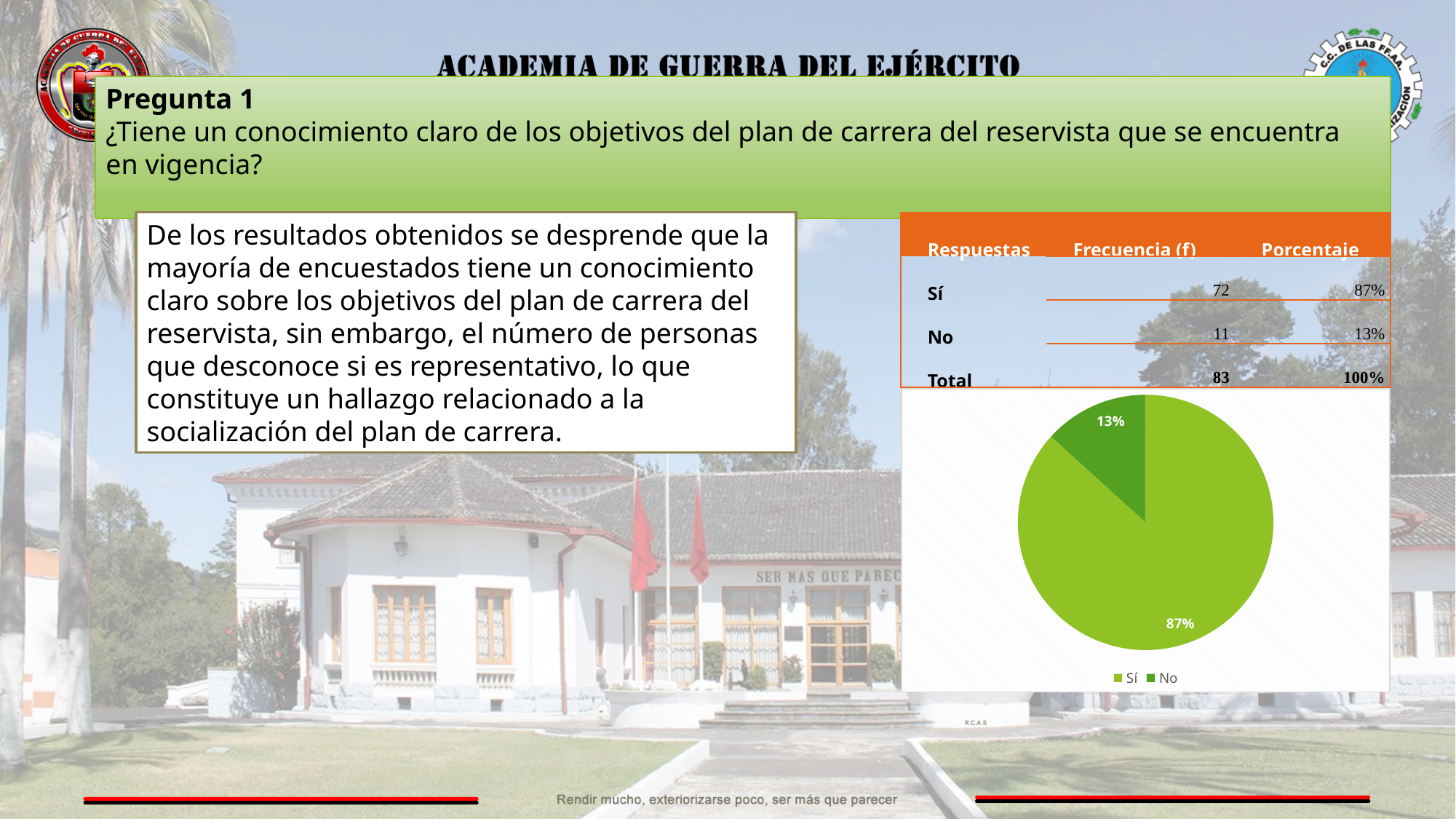
Which slice of the pie chart is the smallest? No How many entries does the legend of the pie chart list? 2 How many slices does the pie chart have? 2 What is the difference in percentage points between the 'Sí' and 'No' slices of the pie chart? 74 What kind of chart is shown on the slide? pie chart Which slice of the pie chart is the largest? Sí Is the 'No' slice of the pie chart greater or less than 50%? less What are the legend entries of the pie chart? Sí, No What share of the pie does the 'Sí' slice represent? 87% What share of the pie does the 'No' slice represent? 13% Which is larger in the pie chart, the 'Sí' slice or the 'No' slice? Sí